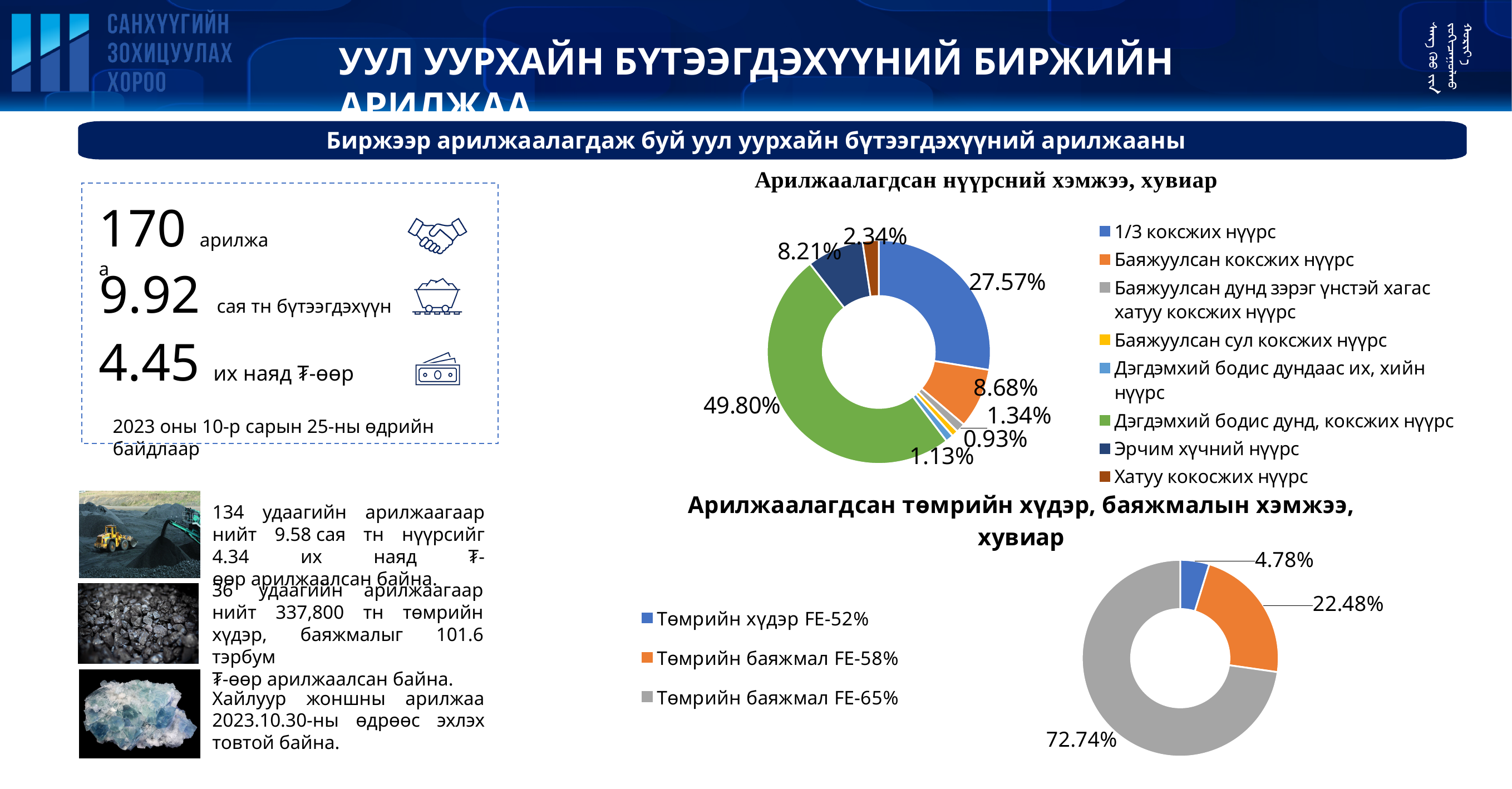
In the chart titled "Арилжаалагдсан нүүрсний хэмжээ, хувиар", what is the difference between the shares of "Баяжуулсан коксжих нүүрс" and "Эрчим хүчний нүүрс"? 0.47% In the chart titled "Арилжаалагдсан нүүрсний хэмжээ, хувиар", what share does "Эрчим хүчний нүүрс" have? 8.21% In the chart titled "Арилжаалагдсан төмрийн хүдэр, баяжмалын хэмжээ, хувиар", what share does "Төмрийн баяжмал FE-65%" have? 72.74% In the chart titled "Арилжаалагдсан нүүрсний хэмжээ, хувиар", which category has the smallest share? Баяжуулсан сул коксжих нүүрс In the chart titled "Арилжаалагдсан нүүрсний хэмжээ, хувиар", which category has the largest share? Дэгдэмхий бодис дунд, коксжих нүүрс In the chart titled "Арилжаалагдсан нүүрсний хэмжээ, хувиар", what share does "1/3 коксжих нүүрс" have? 27.57% In the chart titled "Арилжаалагдсан төмрийн хүдэр, баяжмалын хэмжээ, хувиар", which category has the smallest share? Төмрийн хүдэр FE-52% In the chart titled "Арилжаалагдсан нүүрсний хэмжээ, хувиар", how many categories does the legend list? 8 What kind of chart is "Арилжаалагдсан төмрийн хүдэр, баяжмалын хэмжээ, хувиар"? Doughnut (pie) chart In the chart titled "Арилжаалагдсан нүүрсний хэмжээ, хувиар", which is larger: "Хатуу кокосжих нүүрс" or "Баяжуулсан дунд зэрэг үнстэй хагас хатуу коксжих нүүрс"? Хатуу кокосжих нүүрс In the chart titled "Арилжаалагдсан нүүрсний хэмжээ, хувиар", what share does "Дэгдэмхий бодис дунд, коксжих нүүрс" have? 49.80% In the chart titled "Арилжаалагдсан төмрийн хүдэр, баяжмалын хэмжээ, хувиар", what is the difference between the shares of "Төмрийн баяжмал FE-58%" and "Төмрийн хүдэр FE-52%"? 17.70%